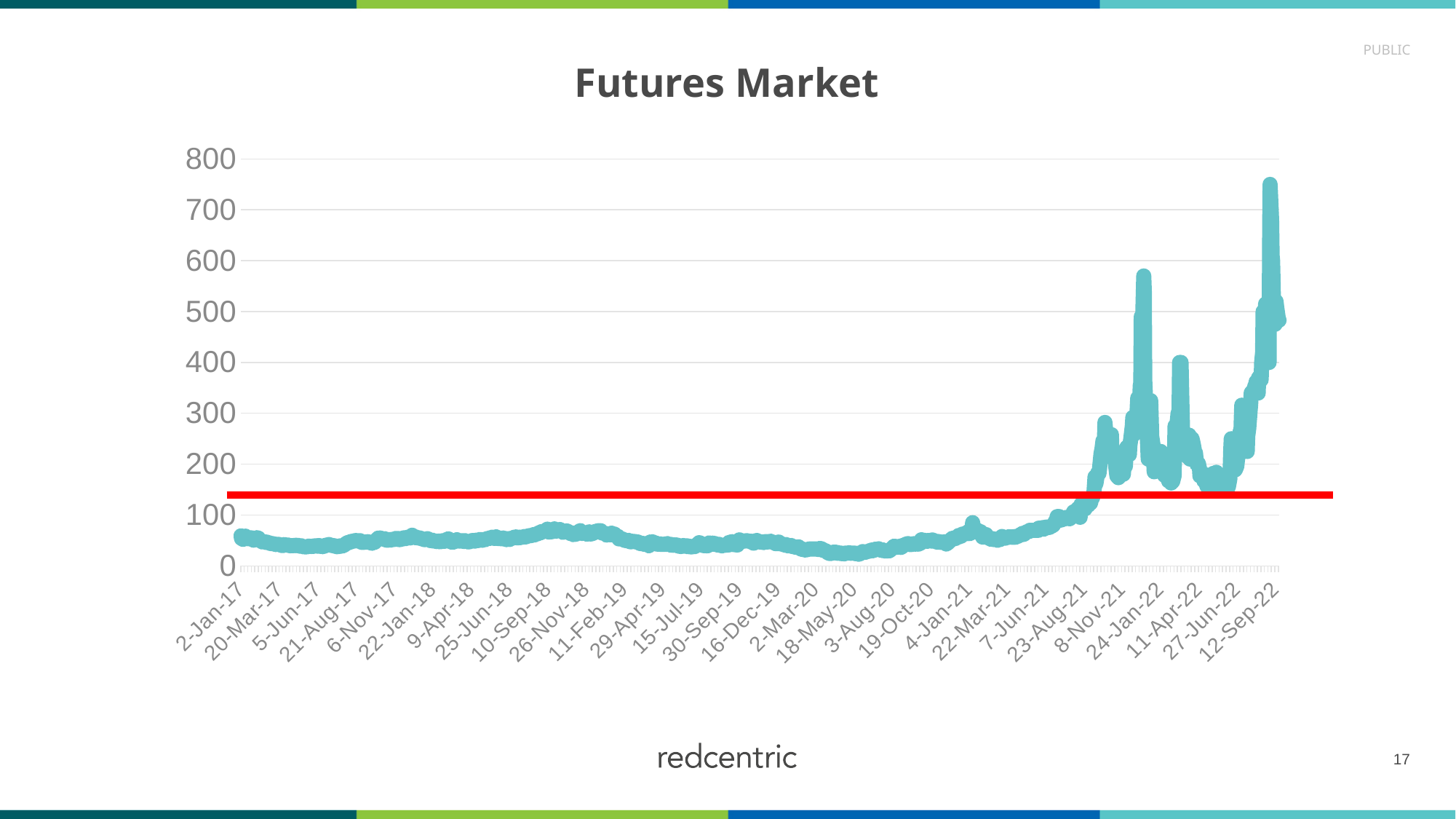
Is the value at 18-May-20 greater or less than 100? less Is the value at 2-Jan-17 greater or less than 100? less What kind of chart is shown on the slide? line chart What colour is the horizontal reference line drawn across the chart? red Is the final value at 12-Sep-22 greater or less than 400? greater Which is larger, the value at 2-Jan-17 or the value at 12-Sep-22? 12-Sep-22 What is the highest value shown on the vertical axis? 800 Overall, do the values rise or fall from the start of the x axis to the end? rise How many date labels are shown on the x axis? 28 What is the title of the chart? Futures Market